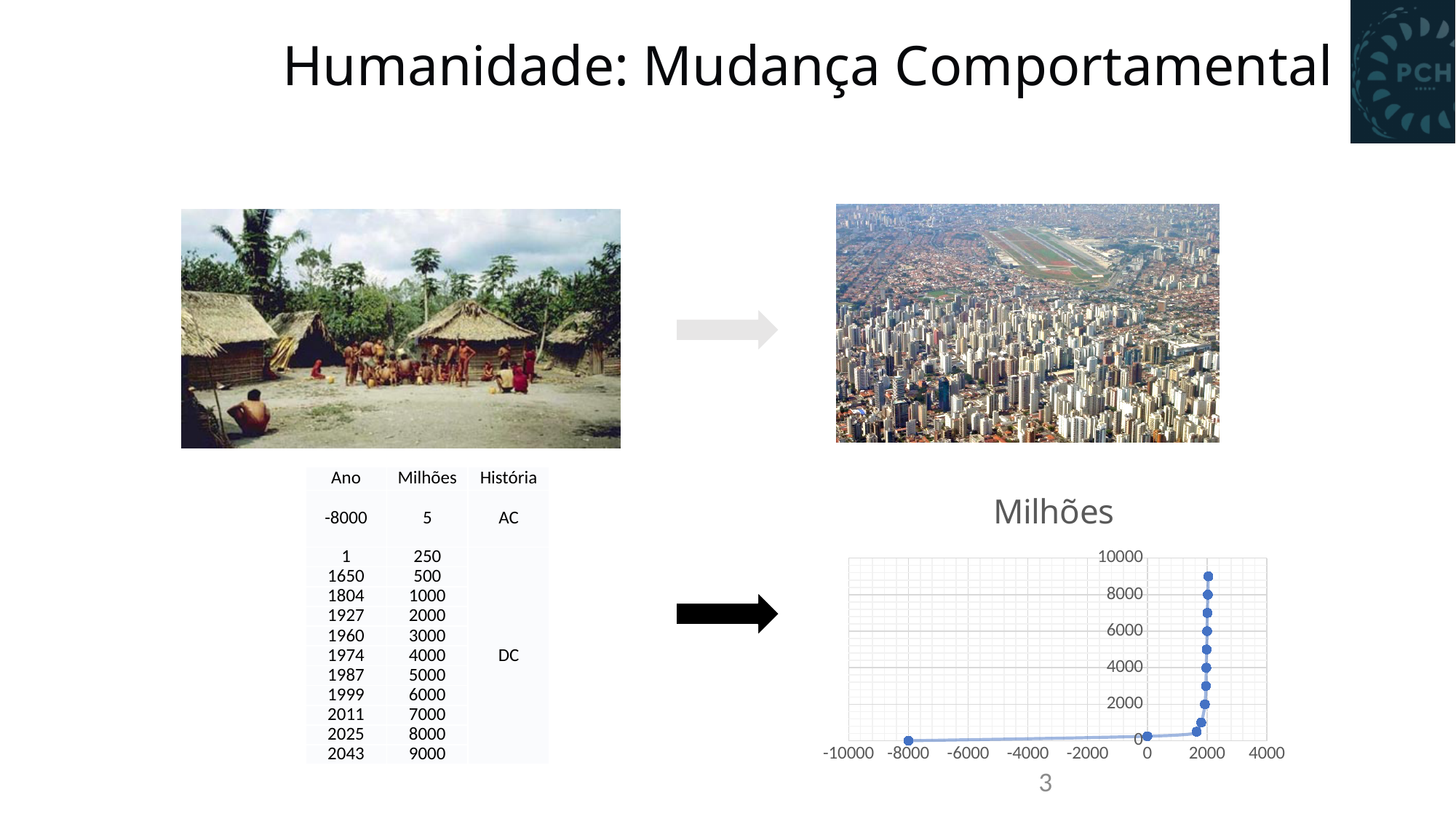
What is the lowest value shown on the horizontal axis of the chart? -10000 Is the value of the topmost point on the chart greater or less than 8000? greater What is the title of the chart on the slide? Milhões What kind of chart is shown on the slide? scatter chart What is the highest value shown on the vertical axis of the chart? 10000 Do the plotted values rise or fall as the x axis increases from left to right? rise Is the value of the leftmost point (near x = -8000) greater or less than 2000? less Is the value of the point at x = 0 greater or less than 2000? less How many data points are plotted on the chart? 12